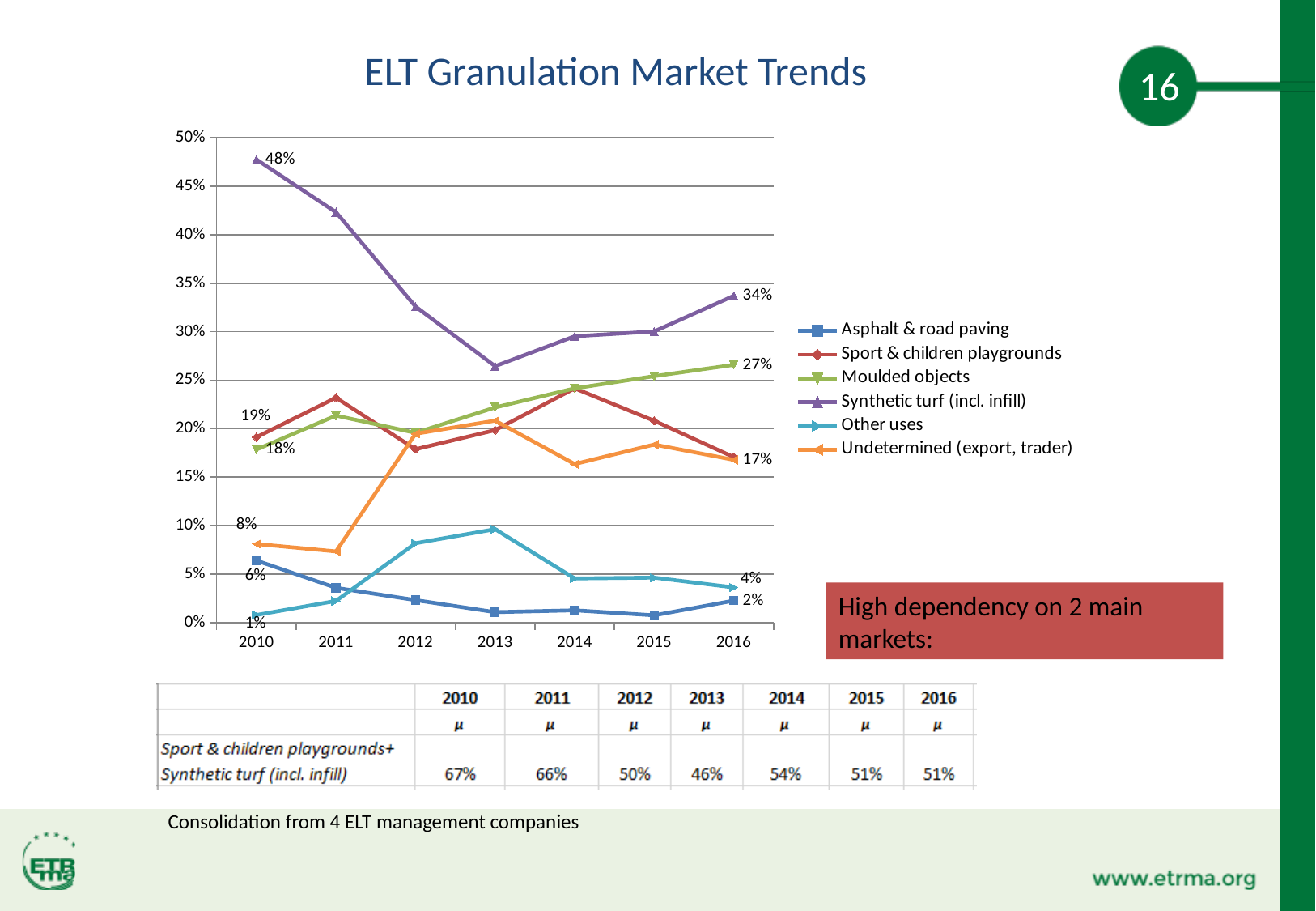
Is the value for Other uses in 2013 greater or less than 5%? greater What is the value for Other uses in 2010? 1% By how many percentage points did Synthetic turf (incl. infill) fall from 2010 to 2016? 14 percentage points How many years are plotted along the x axis? 7 How many series does the legend list? 6 What is the value for Asphalt & road paving in 2010? 6% What is the value for Moulded objects in 2016? 27% What is the value for Synthetic turf (incl. infill) in 2010? 48% What kind of chart is shown on the slide? line chart Does the Synthetic turf (incl. infill) line rise or fall from 2010 to 2013? fall What is the value for Synthetic turf (incl. infill) in 2016? 34% Which series has the highest value in 2010? Synthetic turf (incl. infill)